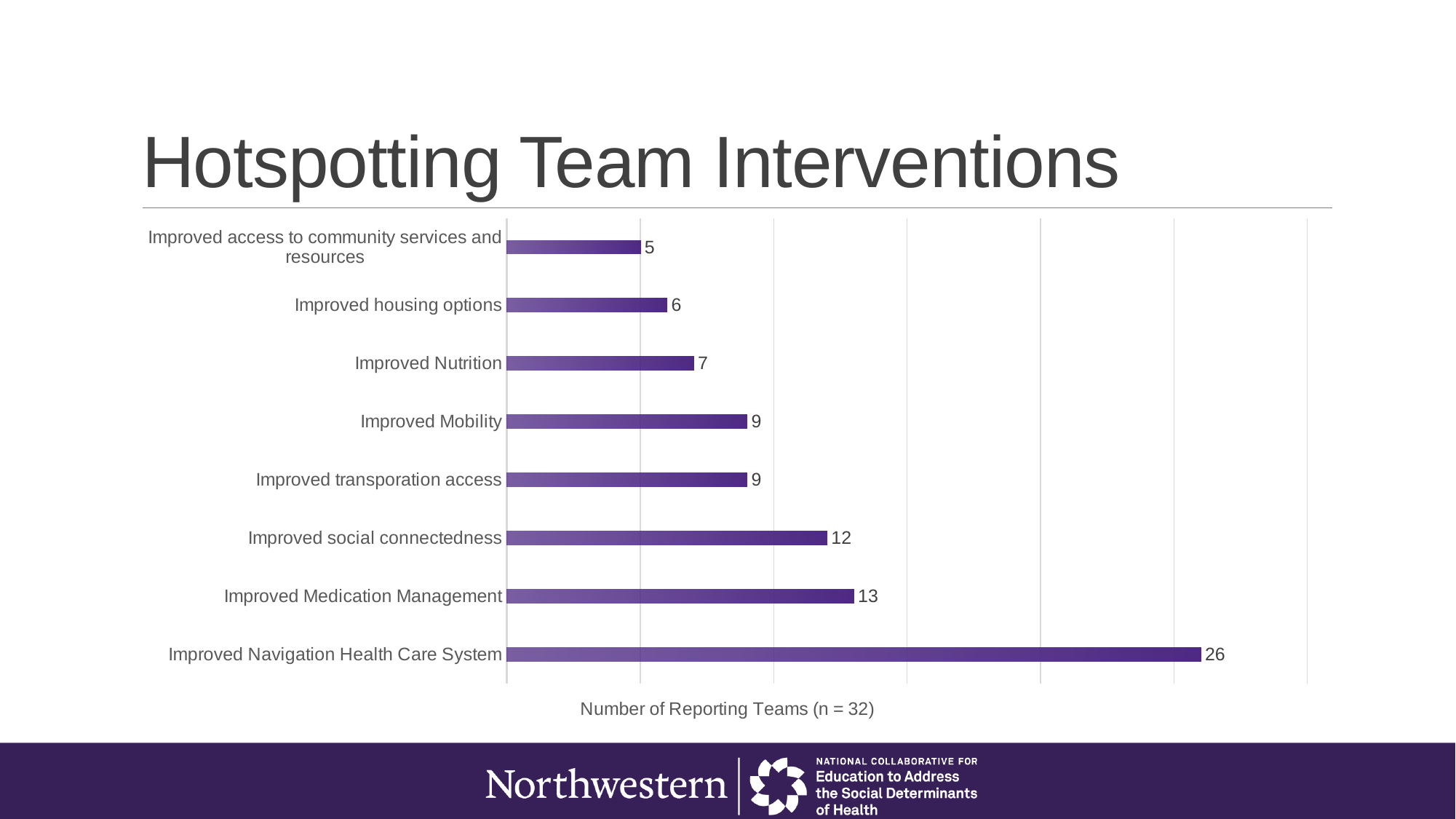
Which is larger, Improved Mobility or Improved Nutrition? Improved Mobility What is the x-axis title of the chart? Number of Reporting Teams (n = 32) What is the difference between Improved Navigation Health Care System and Improved Medication Management? 13 What kind of chart is shown on the slide? Bar chart Which category has the lowest value? Improved access to community services and resources What is the difference between Improved social connectedness and Improved Nutrition? 5 What is the value for Improved housing options? 6 Which category has the highest value? Improved Navigation Health Care System How many categories are shown in the chart? 8 What is the value for Improved Navigation Health Care System? 26 What is the title of the slide? Hotspotting Team Interventions What is the value for Improved Medication Management? 13